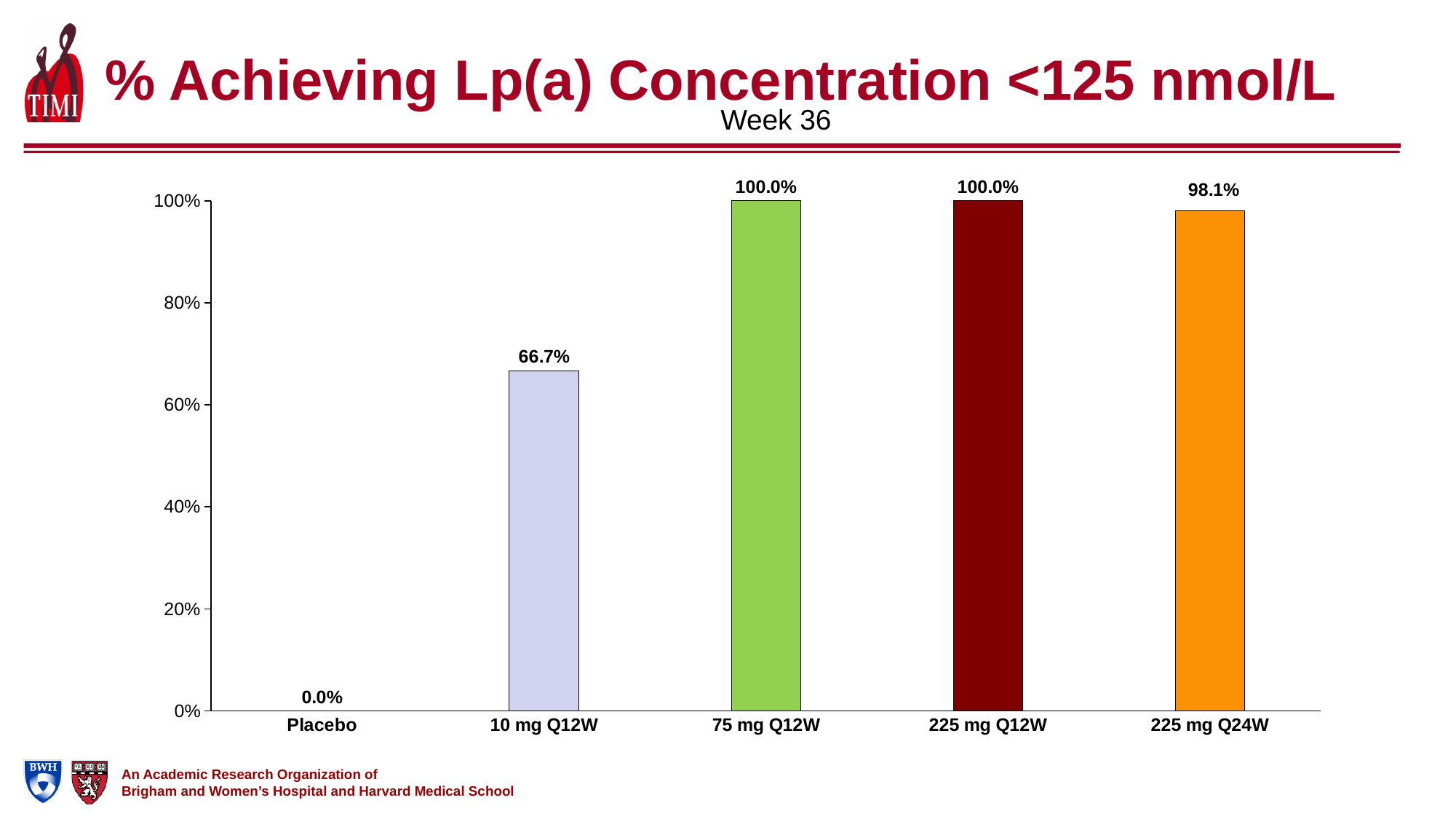
Which category has the lowest value? Placebo Is the value for 10 mg Q12W greater or less than 60%? greater How many categories are shown on the x axis? 5 Which is larger, the value for 10 mg Q12W or the value for 225 mg Q24W? 225 mg Q24W What is the difference between the values for 75 mg Q12W and 10 mg Q12W? 33.3% What is the value for Placebo? 0.0% What week does the chart subtitle refer to? Week 36 What is the value for 10 mg Q12W? 66.7% What kind of chart is shown on the slide? bar chart What is the value for 225 mg Q24W? 98.1% What is the difference between the values for 225 mg Q12W and 225 mg Q24W? 1.9% What is the value for 75 mg Q12W? 100.0%